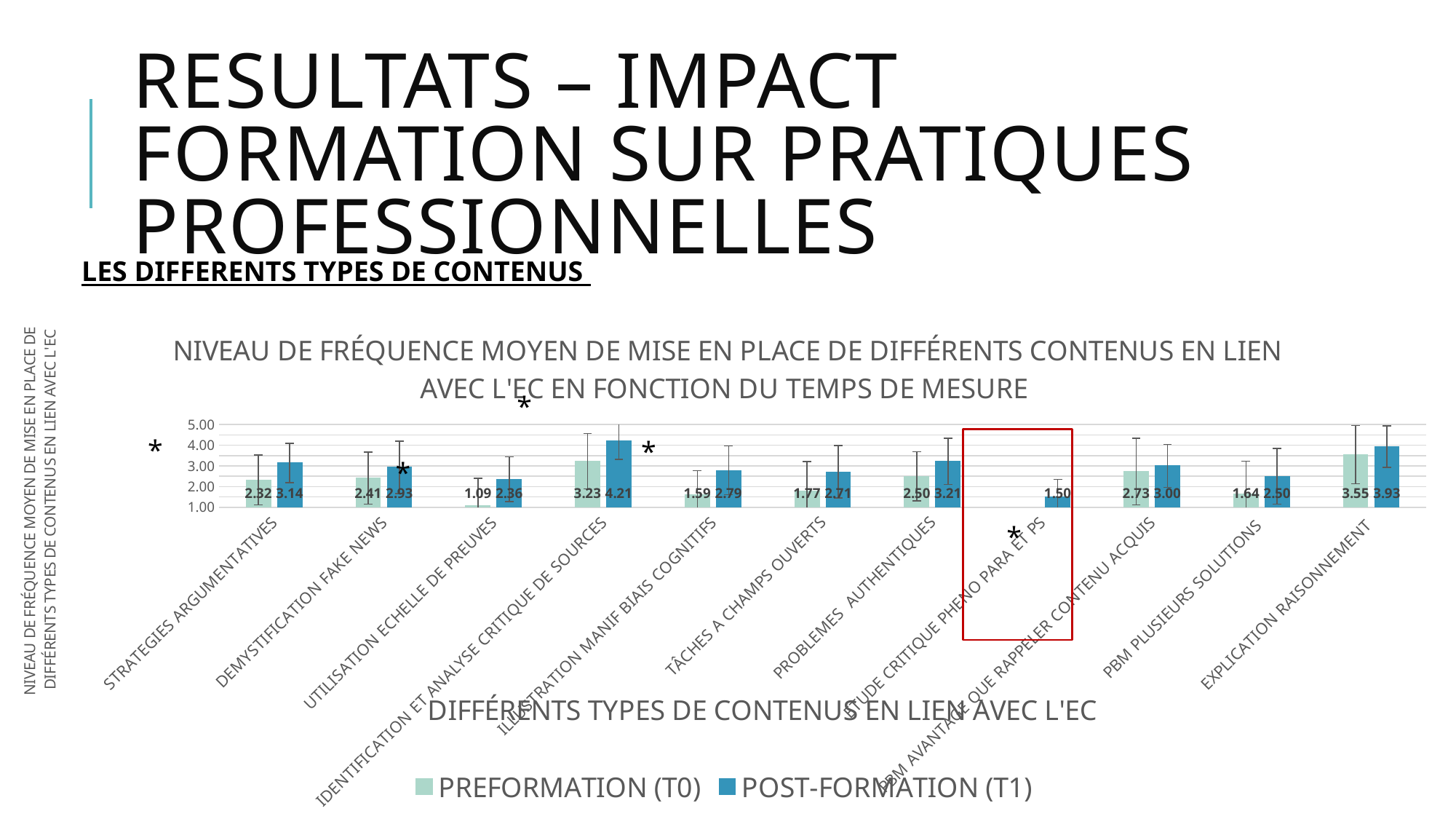
What is the POST-FORMATION (T1) value for IDENTIFICATION ET ANALYSE CRITIQUE DE SOURCES? 4.21 What are the two series named in the legend? PREFORMATION (T0) and POST-FORMATION (T1) What is the PREFORMATION (T0) value for UTILISATION ECHELLE DE PREUVES? 1.09 What is the POST-FORMATION (T1) value for PBM AVANTAGE QUE RAPPELER CONTENU ACQUIS? 3.00 What is the difference between the POST-FORMATION (T1) and PREFORMATION (T0) values for EXPLICATION RAISONNEMENT? 0.38 How many categories of content are shown on the x axis? 11 What is the difference between the POST-FORMATION (T1) and PREFORMATION (T0) values for STRATEGIES ARGUMENTATIVES? 0.82 Which has the larger POST-FORMATION (T1) value: TÂCHES A CHAMPS OUVERTS or PBM PLUSIEURS SOLUTIONS? TÂCHES A CHAMPS OUVERTS Which category has the highest POST-FORMATION (T1) value? IDENTIFICATION ET ANALYSE CRITIQUE DE SOURCES How many series does the legend list? 2 What kind of chart is shown on the slide? Bar chart Which category has the lowest POST-FORMATION (T1) value? ETUDE CRITIQUE PHENO PARA ET PS